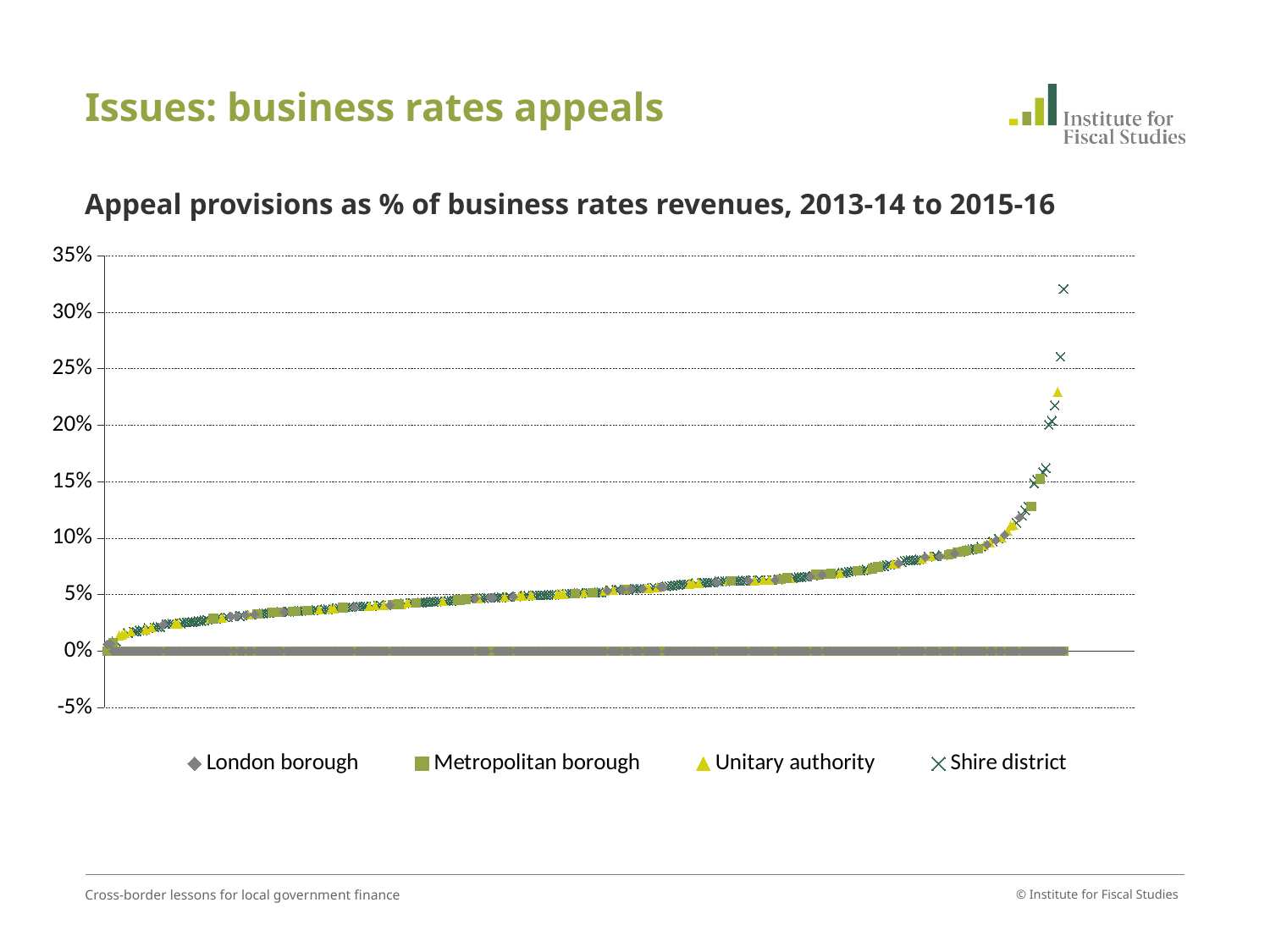
Which series contains the highest plotted point on the chart? Shire district Is the highest plotted point on the chart greater or less than 30%? greater Is the highest Unitary authority point greater or less than 20%? greater Which series is marked with an x symbol in the legend? Shire district How many series does the chart legend list? 4 Is the highest plotted point on the chart greater or less than 35%? less Do the plotted values rise or fall moving from left to right along the x axis? rise What is the title of the chart? Appeal provisions as % of business rates revenues, 2013-14 to 2015-16 What is the highest value shown on the vertical axis? 35% What kind of chart is shown on the slide? Scatter chart